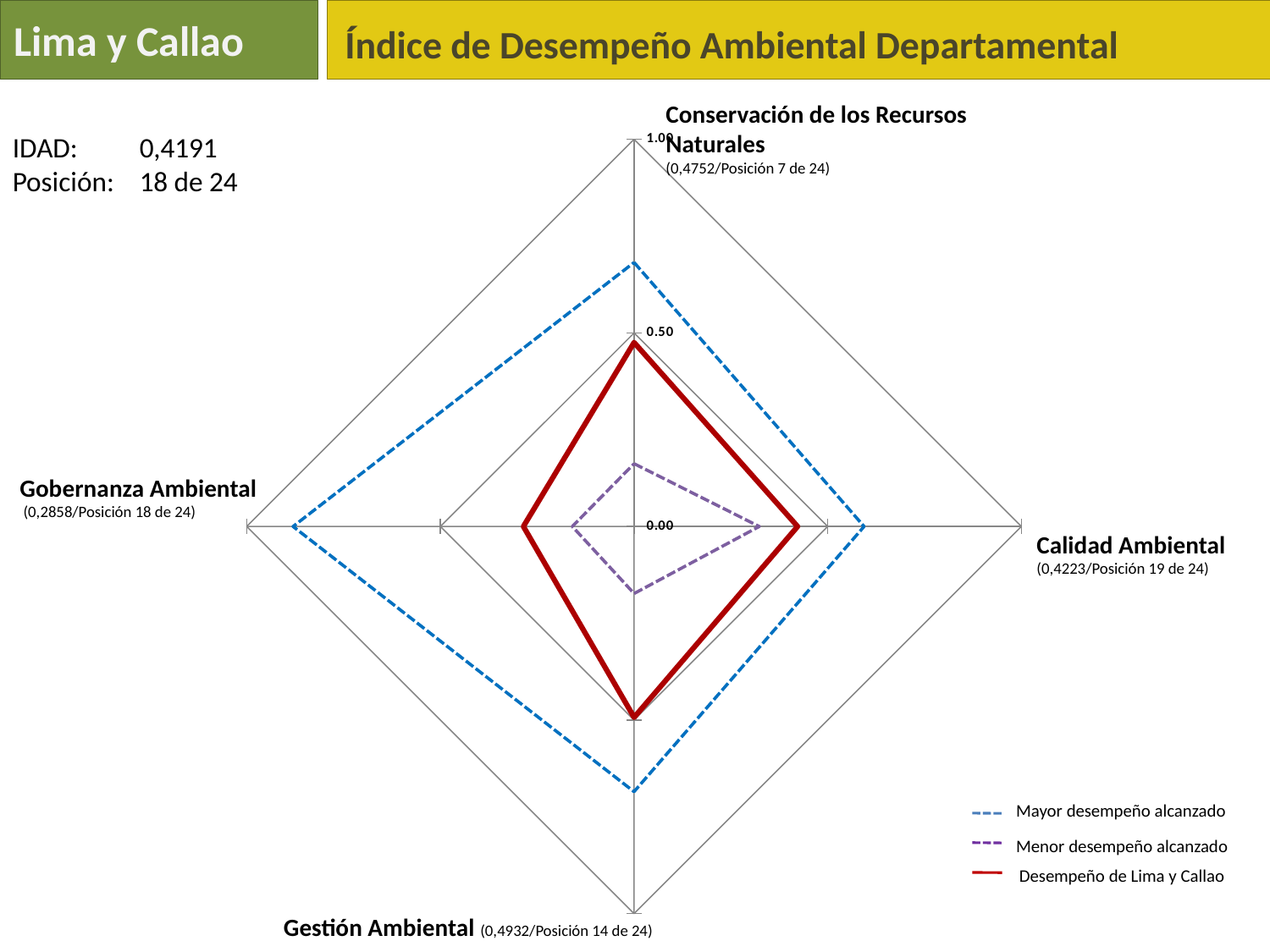
What is the difference between Lima y Callao's values for Gestión Ambiental and Gobernanza Ambiental? 0,2074 Which series is drawn with a solid red line? Desempeño de Lima y Callao Is the value of the Mayor desempeño alcanzado series on the Gobernanza Ambiental axis greater or less than 0.50? greater How many series does the legend list? 3 What is the value for Lima y Callao on the Gestión Ambiental axis? 0,4932 What position does Lima y Callao hold for Conservación de los Recursos Naturales? 7 de 24 Which is larger for Lima y Callao: Conservación de los Recursos Naturales or Calidad Ambiental? Conservación de los Recursos Naturales What is the value for Lima y Callao on the Gobernanza Ambiental axis? 0,2858 On which axis does Lima y Callao have its lowest value? Gobernanza Ambiental How many axes (categories) does the radar chart have? 4 On which axis does Lima y Callao have its highest value? Gestión Ambiental What kind of chart is shown on the slide? Radar chart